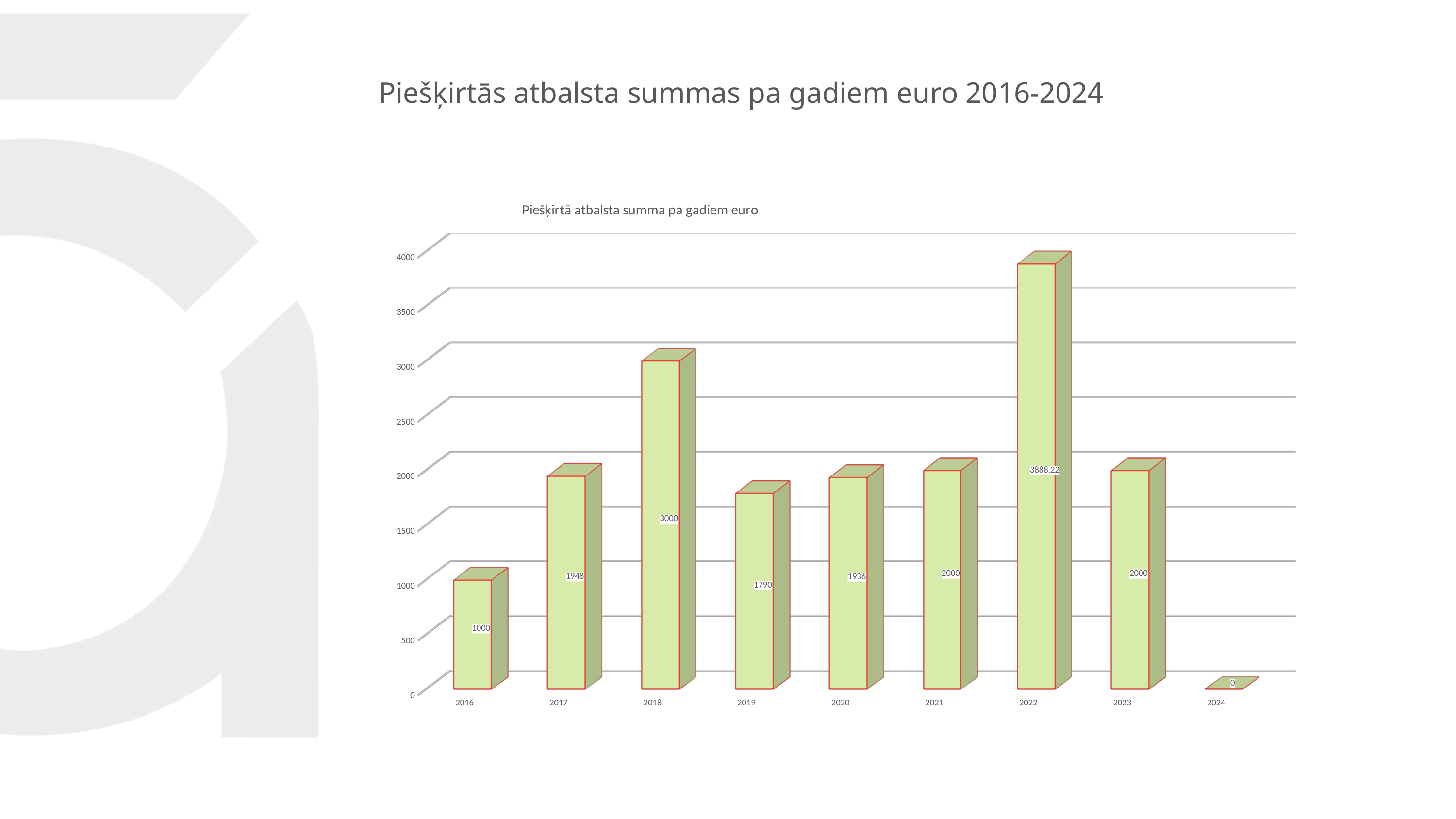
What is the value for 2024? 0 Which is larger, the value for 2020 or the value for 2017? 2017 What is the difference between the values for 2022 and 2023? 1888.22 How many years are shown on the x axis? 9 What is the difference between the values for 2018 and 2016? 2000 What is the value for 2019? 1790 What is the value for 2022? 3888.22 Which year has the lowest value? 2024 What is the title of the chart? Piešķirtā atbalsta summa pa gadiem euro What is the value for 2017? 1948 Which year has the highest value? 2022 What kind of chart is shown on the slide? bar chart